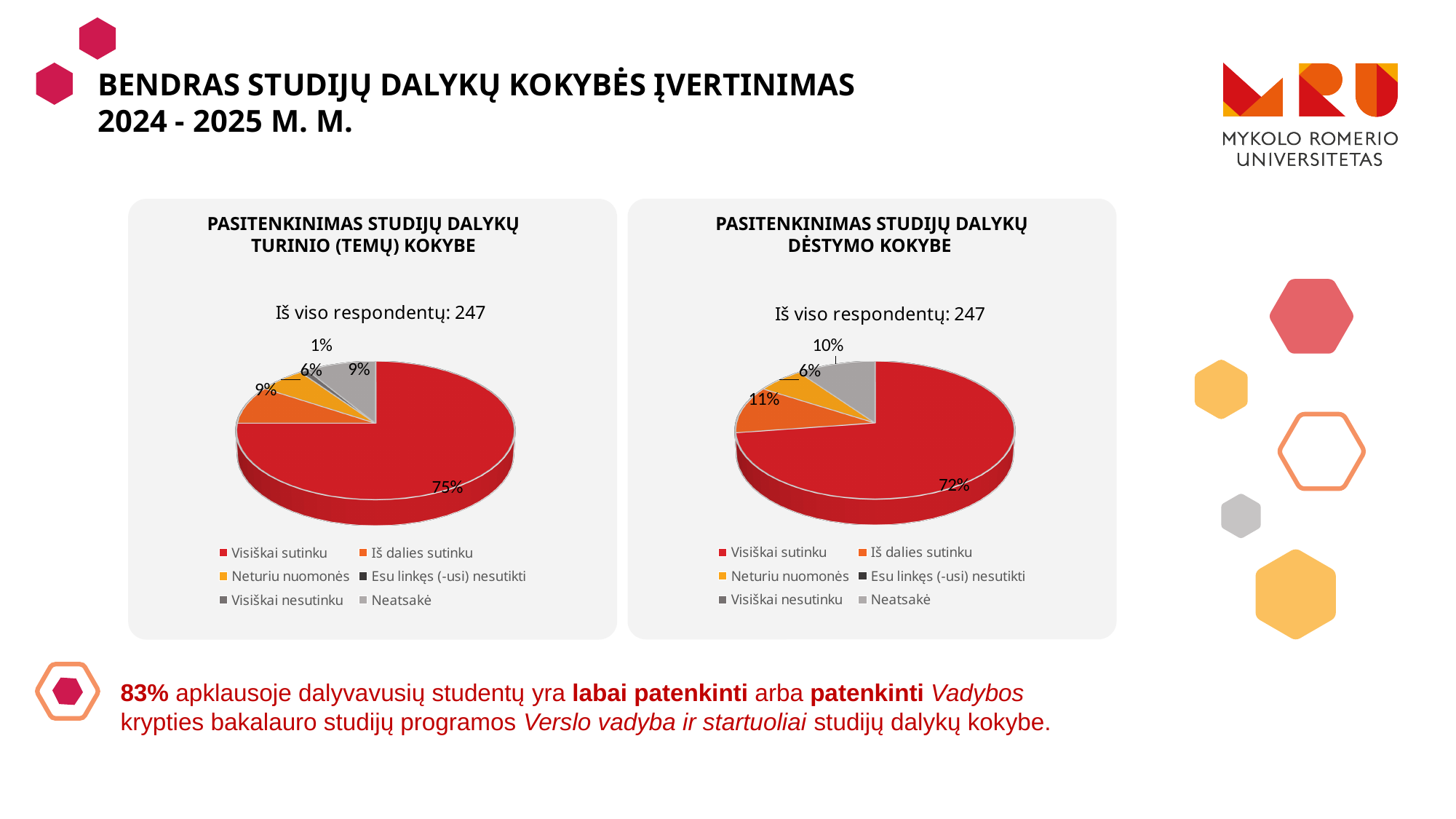
In the right chart (Pasitenkinimas studijų dalykų dėstymo kokybe), which answer has the largest share? Visiškai sutinku How many respondents in total are reported for the right chart (Pasitenkinimas studijų dalykų dėstymo kokybe)? 247 In the right chart (Pasitenkinimas studijų dalykų dėstymo kokybe), what share of respondents answered "Iš dalies sutinku"? 11% How many entries does the legend of the left chart list? 6 What type of chart is used on this slide? Pie chart In the right chart (Pasitenkinimas studijų dalykų dėstymo kokybe), what share of respondents answered "Neatsakė"? 10% In the left chart (Pasitenkinimas studijų dalykų turinio (temų) kokybe), what share of respondents answered "Visiškai sutinku"? 75% In the left chart (Pasitenkinimas studijų dalykų turinio (temų) kokybe), which answer has the largest share? Visiškai sutinku In the left chart (Pasitenkinimas studijų dalykų turinio (temų) kokybe), what share of respondents answered "Neatsakė"? 9% What is the difference between the "Visiškai sutinku" share in the left chart and the "Visiškai sutinku" share in the right chart? 3 percentage points In the right chart (Pasitenkinimas studijų dalykų dėstymo kokybe), which is larger: the "Iš dalies sutinku" share or the "Neturiu nuomonės" share? Iš dalies sutinku In the right chart (Pasitenkinimas studijų dalykų dėstymo kokybe), what share of respondents answered "Visiškai sutinku"? 72%